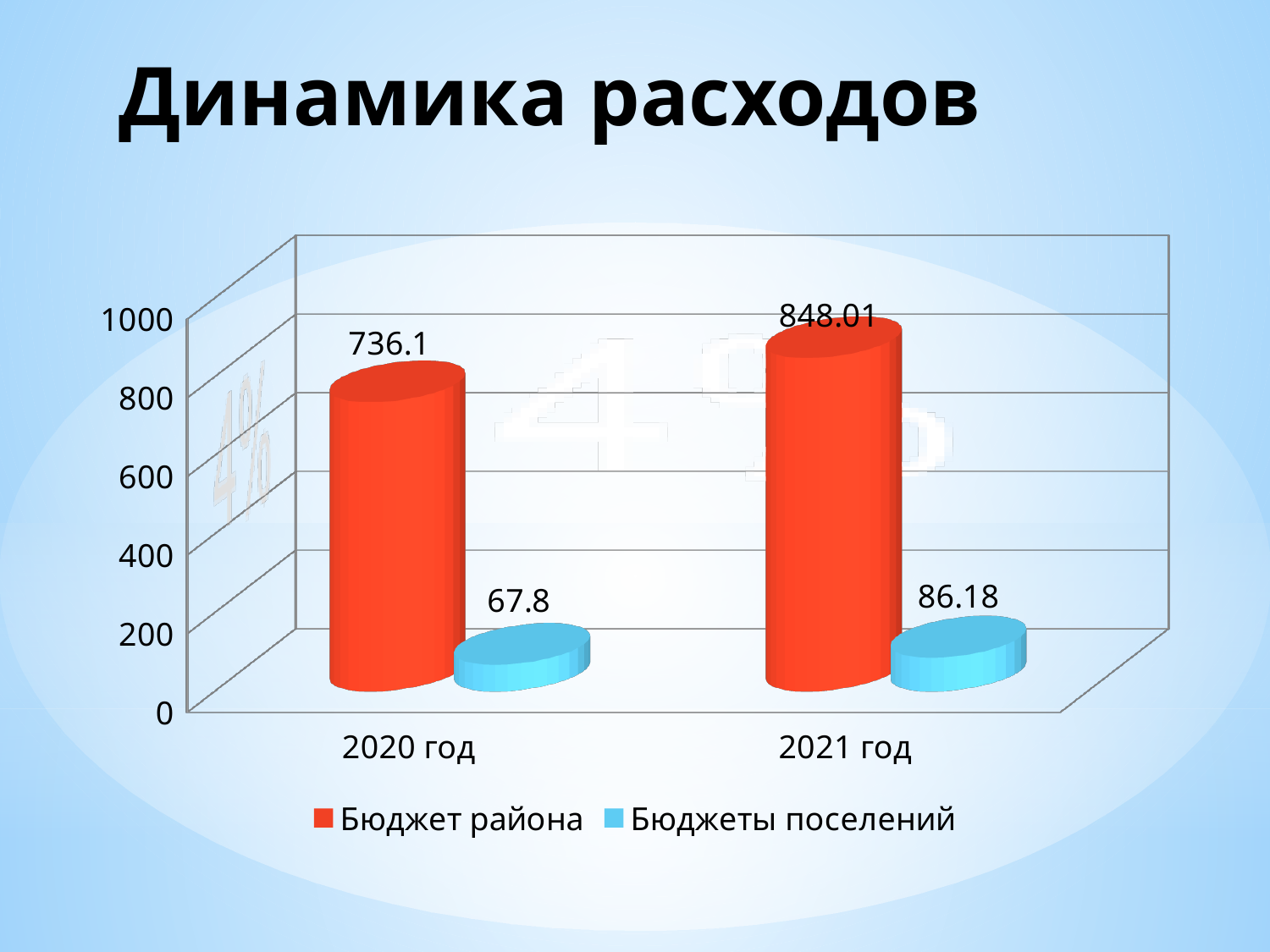
What is the difference between the Бюджет района values for 2021 год and 2020 год? 111.91 How many series does the legend list? 2 Does the value for Бюджет района rise or fall from 2020 год to 2021 год? Rise What is the value for Бюджеты поселений in 2020 год? 67.8 What is the difference between the Бюджеты поселений values for 2021 год and 2020 год? 18.38 What is the value for Бюджеты поселений in 2021 год? 86.18 What is the value for Бюджет района in 2021 год? 848.01 In which year is the value for Бюджет района highest? 2021 год What is the value for Бюджет района in 2020 год? 736.1 What kind of chart is shown on the slide? Bar chart Which is larger in 2021 год: Бюджет района or Бюджеты поселений? Бюджет района In which year is the value for Бюджеты поселений lowest? 2020 год